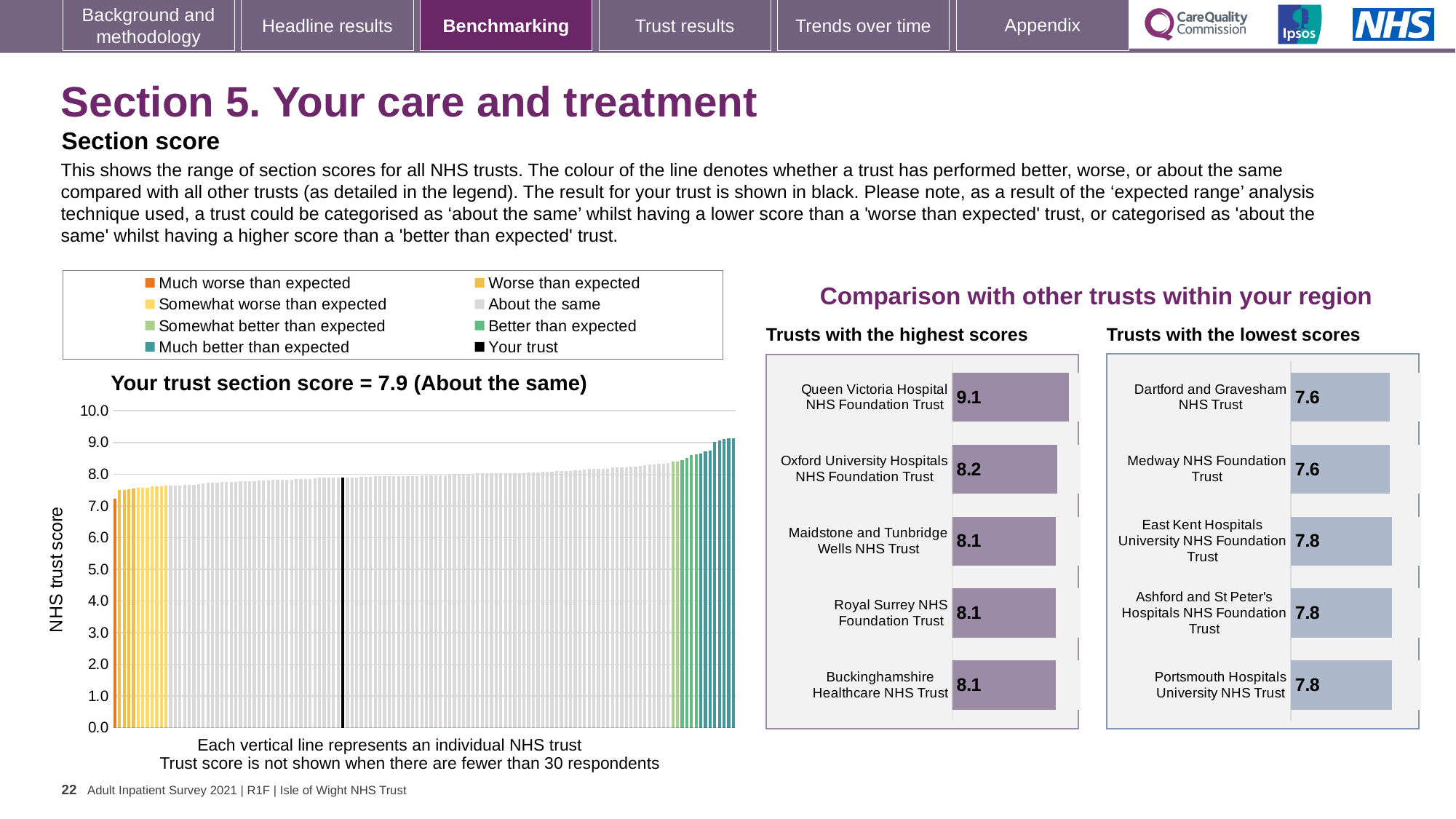
On the 'Trusts with the highest scores' chart, which trust has the highest score? Queen Victoria Hospital NHS Foundation Trust On the 'Trusts with the highest scores' chart, what is the score for Queen Victoria Hospital NHS Foundation Trust? 9.1 Which is larger: the score for Queen Victoria Hospital NHS Foundation Trust on the 'Trusts with the highest scores' chart or the score for East Kent Hospitals University NHS Foundation Trust on the 'Trusts with the lowest scores' chart? Queen Victoria Hospital NHS Foundation Trust On the 'Your trust section score' chart, how many entries does the legend list? 8 On the 'Your trust section score' chart, what kind of chart is shown? bar chart On the 'Trusts with the highest scores' chart, how many trusts are shown? 5 On the 'Trusts with the lowest scores' chart, what is the difference between the scores of Portsmouth Hospitals University NHS Trust and Dartford and Gravesham NHS Trust? 0.2 On the 'Trusts with the lowest scores' chart, what is the score for Medway NHS Foundation Trust? 7.6 On the 'Your trust section score' chart, which category is your trust placed in? About the same On the 'Trusts with the highest scores' chart, what is the difference between the scores of Queen Victoria Hospital NHS Foundation Trust and Oxford University Hospitals NHS Foundation Trust? 0.9 On the 'Your trust section score' chart, what is the section score for your trust? 7.9 On the 'Your trust section score' chart, do the bar heights rise or fall from left to right? rise